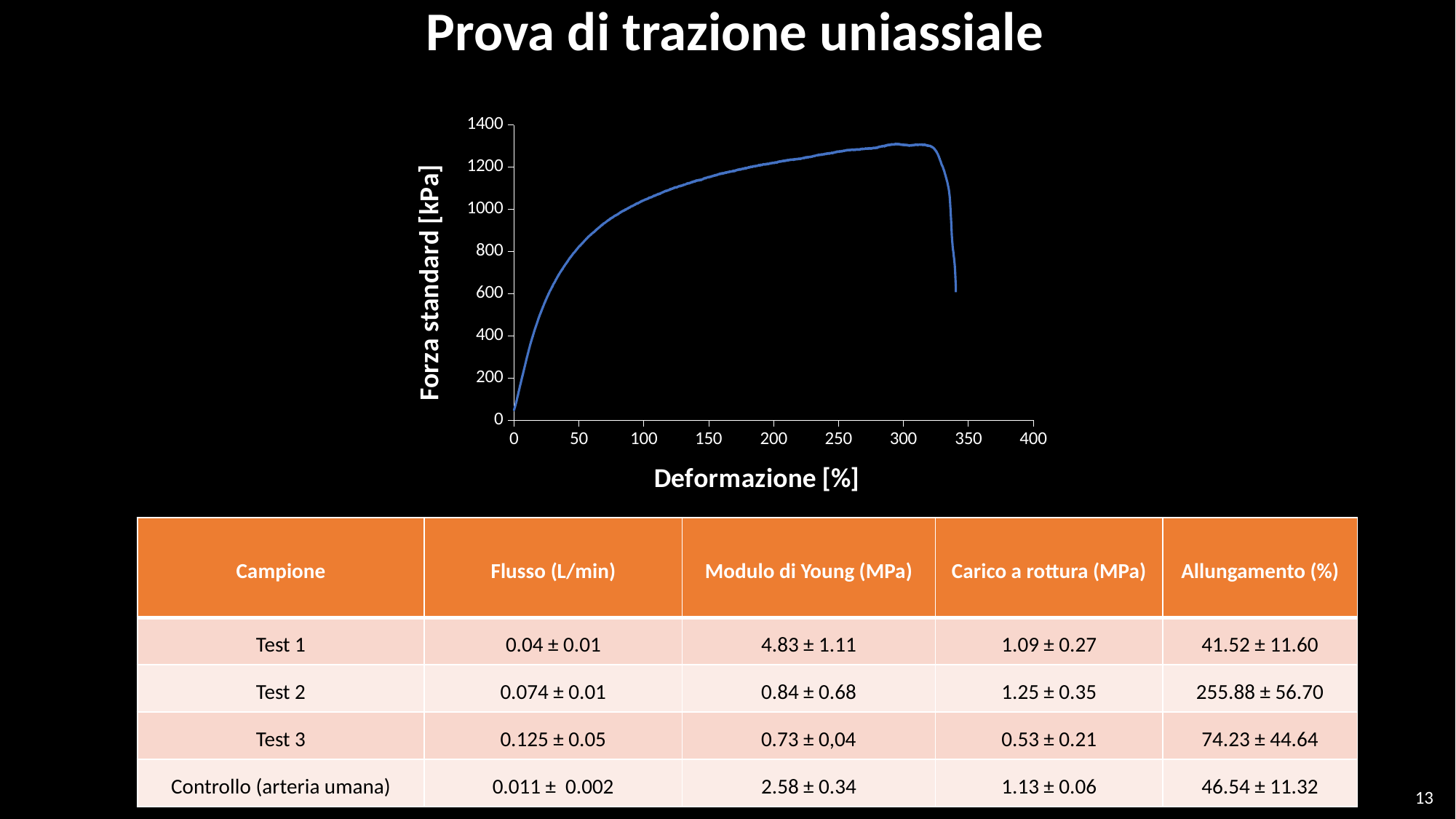
Is the Forza standard at the end of the curve (around 340%) larger or smaller than at 250%? smaller What is the title of the x axis of the chart? Deformazione [%] What is the title of the y axis of the chart? Forza standard [kPa] What kind of chart is shown on the slide? line chart Is the Forza standard at a Deformazione of 150% larger or smaller than at 50%? larger Does the curve rise or fall between a Deformazione of 320% and 340%? fall Is the highest value reached by the curve greater or less than 1400? less Does the curve rise or fall between a Deformazione of 0% and 250%? rise Is the value of Forza standard at a Deformazione of 300% greater or less than 1200? greater Is the value of Forza standard at a Deformazione of 200% greater or less than 1000? greater